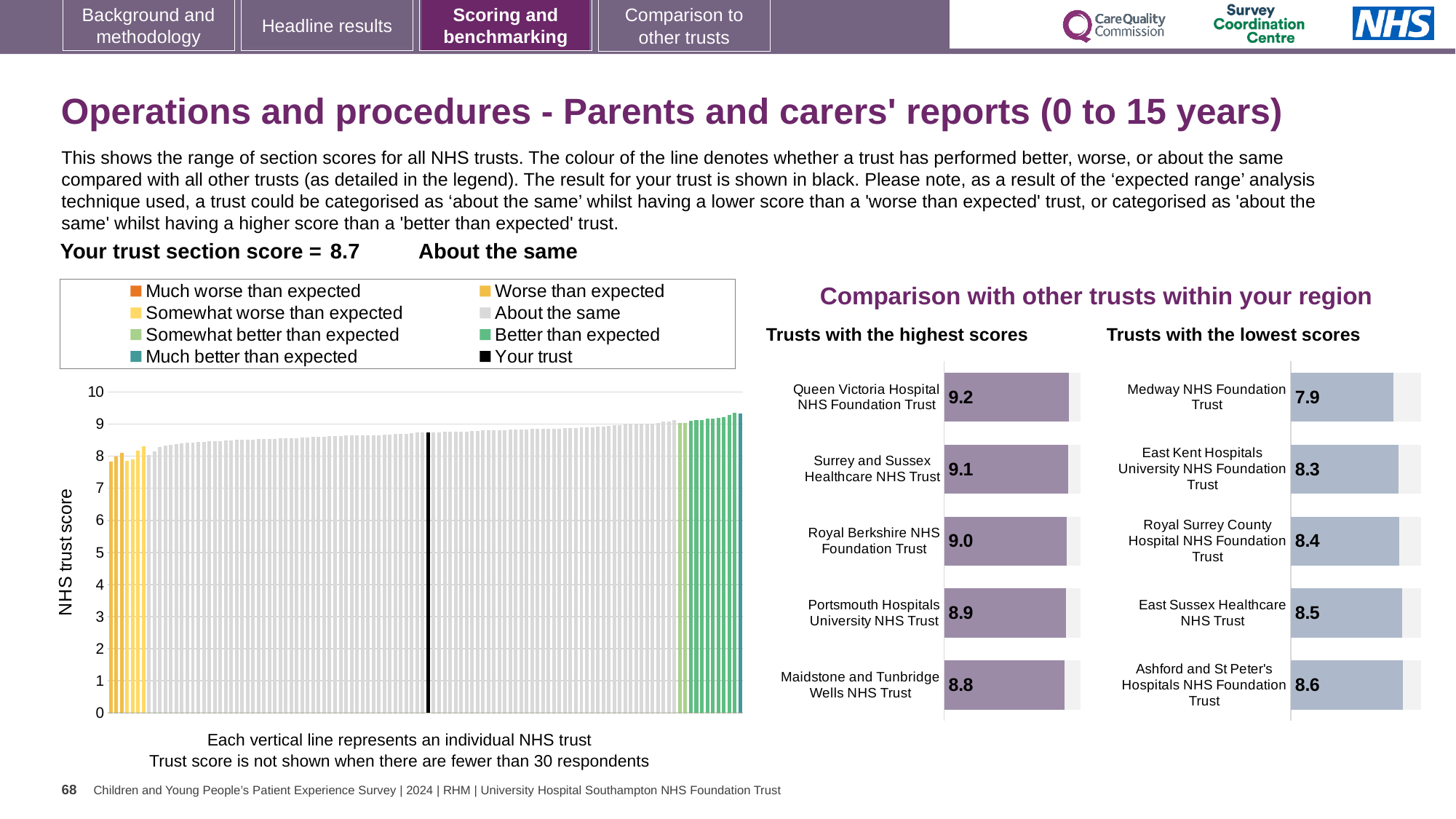
In the 'Trusts with the lowest scores' chart, which has the larger score: East Kent Hospitals University NHS Foundation Trust or East Sussex Healthcare NHS Trust? East Sussex Healthcare NHS Trust How many trusts are listed in the 'Trusts with the highest scores' chart? 5 How many entries does the legend of the 'NHS trust score' chart list? 8 In the 'Trusts with the lowest scores' chart, which trust has the highest score shown? Ashford and St Peter's Hospitals NHS Foundation Trust In the 'NHS trust score' chart on the left, is the value of the black bar (your trust) greater or less than 8? greater What kind of chart is the 'NHS trust score' chart on the left of the slide? Bar chart In the 'NHS trust score' chart on the left, what colour is the bar representing your trust? Black In the 'NHS trust score' chart on the left, do the bar values rise or fall from left to right? Rise In the 'Trusts with the highest scores' chart, which trust has the lowest score shown? Maidstone and Tunbridge Wells NHS Trust In the 'Trusts with the highest scores' chart, what is the score for Queen Victoria Hospital NHS Foundation Trust? 9.2 What is the difference between the score for Queen Victoria Hospital NHS Foundation Trust in the highest-scores chart and the score for Medway NHS Foundation Trust in the lowest-scores chart? 1.3 In the 'Trusts with the lowest scores' chart, what is the score for Medway NHS Foundation Trust? 7.9